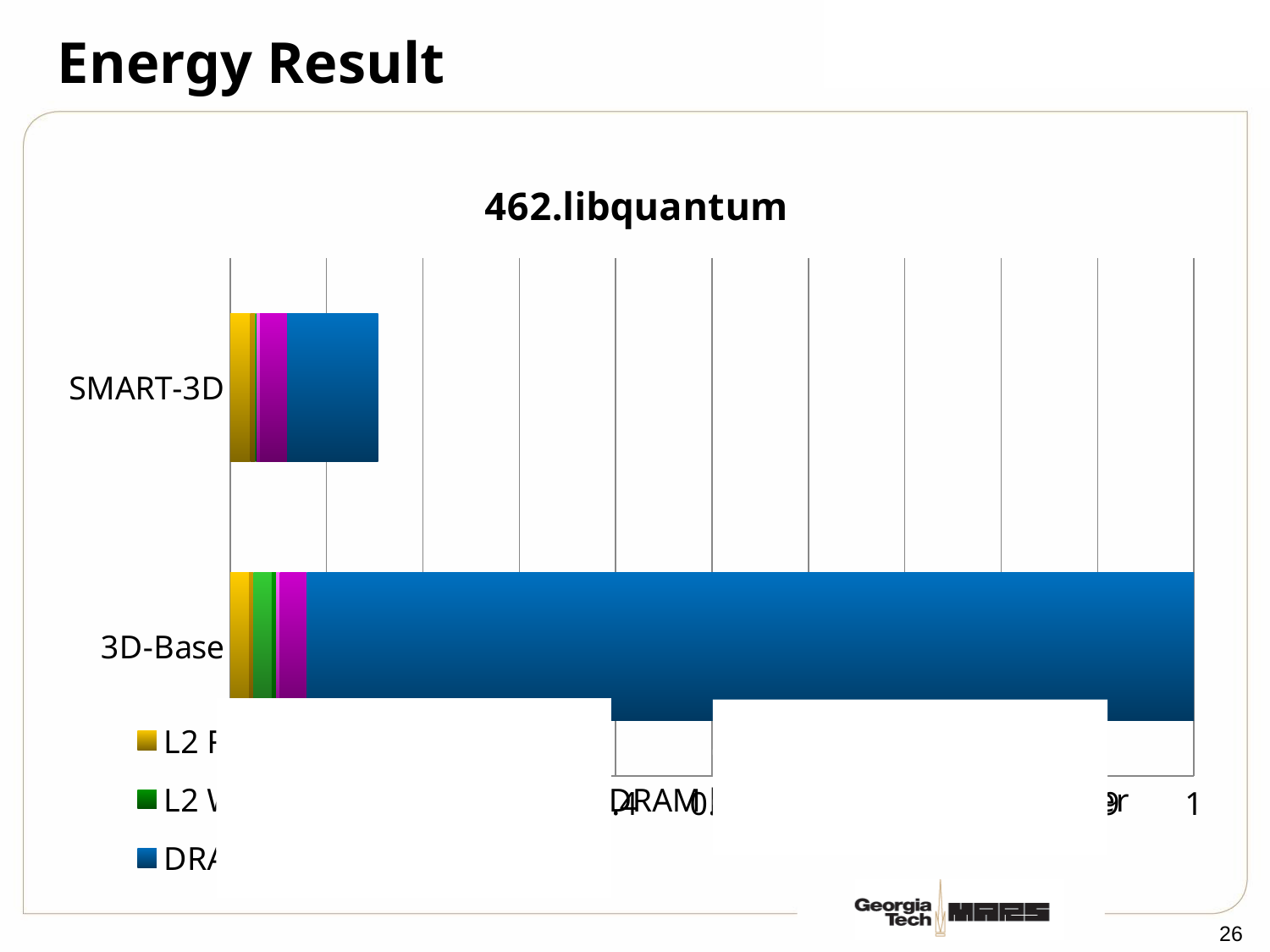
What is the title of the chart? 462.libquantum Is the total value for SMART-3D greater or less than 1? less Which category has the larger blue segment in its bar? 3D-Base How many categories are plotted on the chart? 2 Which category has the longest total bar? 3D-Base What is the total value of the 3D-Base bar, as read from the axis tick it reaches? 1 What kind of chart is shown on the slide? bar chart Which category has the shortest total bar? SMART-3D Which has the larger total bar, SMART-3D or 3D-Base? 3D-Base